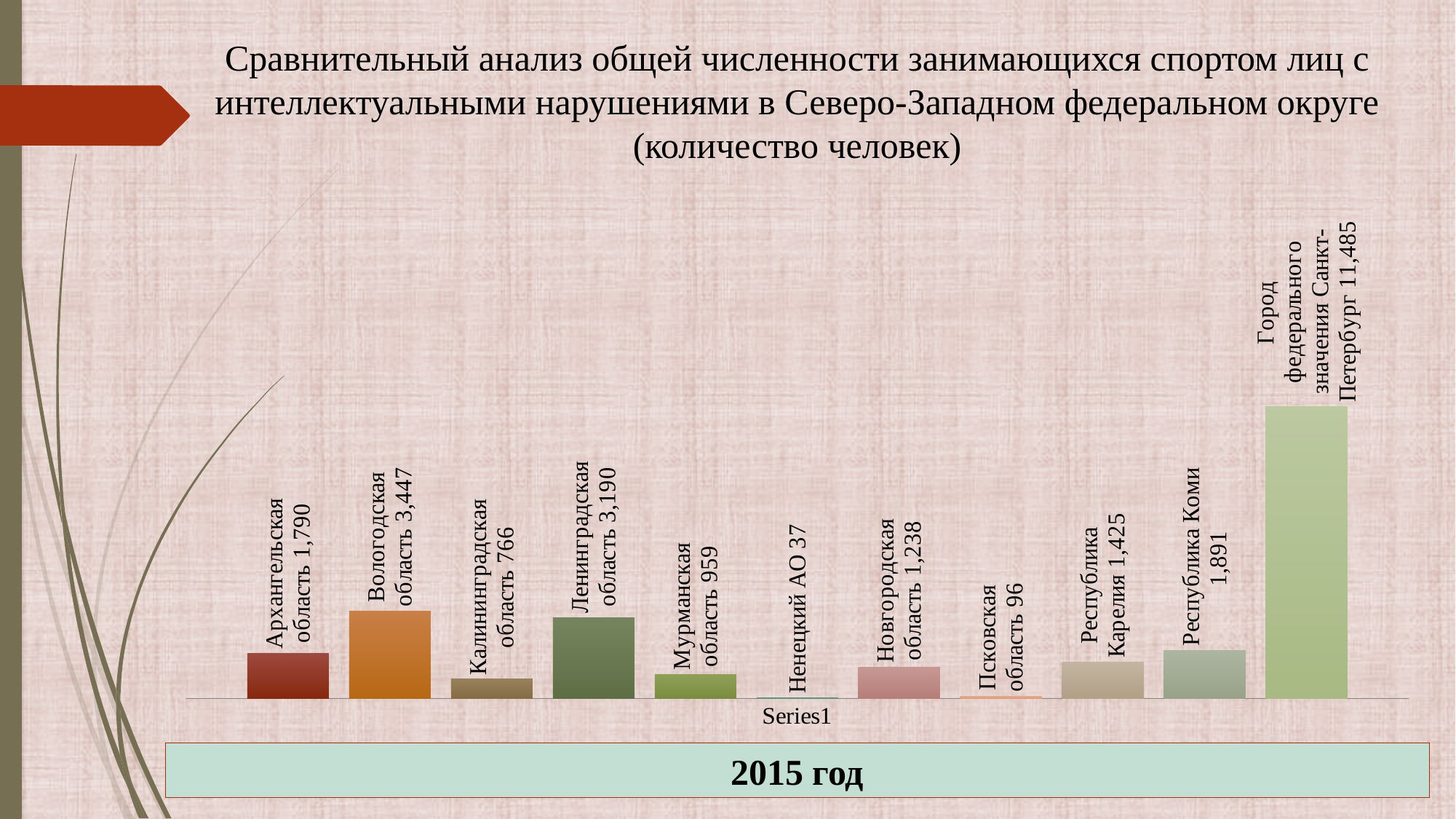
What is the difference between the values for Вологодская область and Ленинградская область? 257 How many categories (bars) are shown in the chart? 11 What kind of chart is shown on the slide? Bar chart What year is indicated in the box below the chart? 2015 год What is the value for Вологодская область? 3,447 Which is larger, the value for Новгородская область or the value for Республика Карелия? Республика Карелия What is the value for Ненецкий АО? 37 Which category has the highest value? Город федерального значения Санкт-Петербург What is the value for Республика Коми? 1,891 Which category has the lowest value? Ненецкий АО Which is larger, the value for Мурманская область or the value for Калининградская область? Мурманская область What is the difference between the values for Республика Коми and Архангельская область? 101